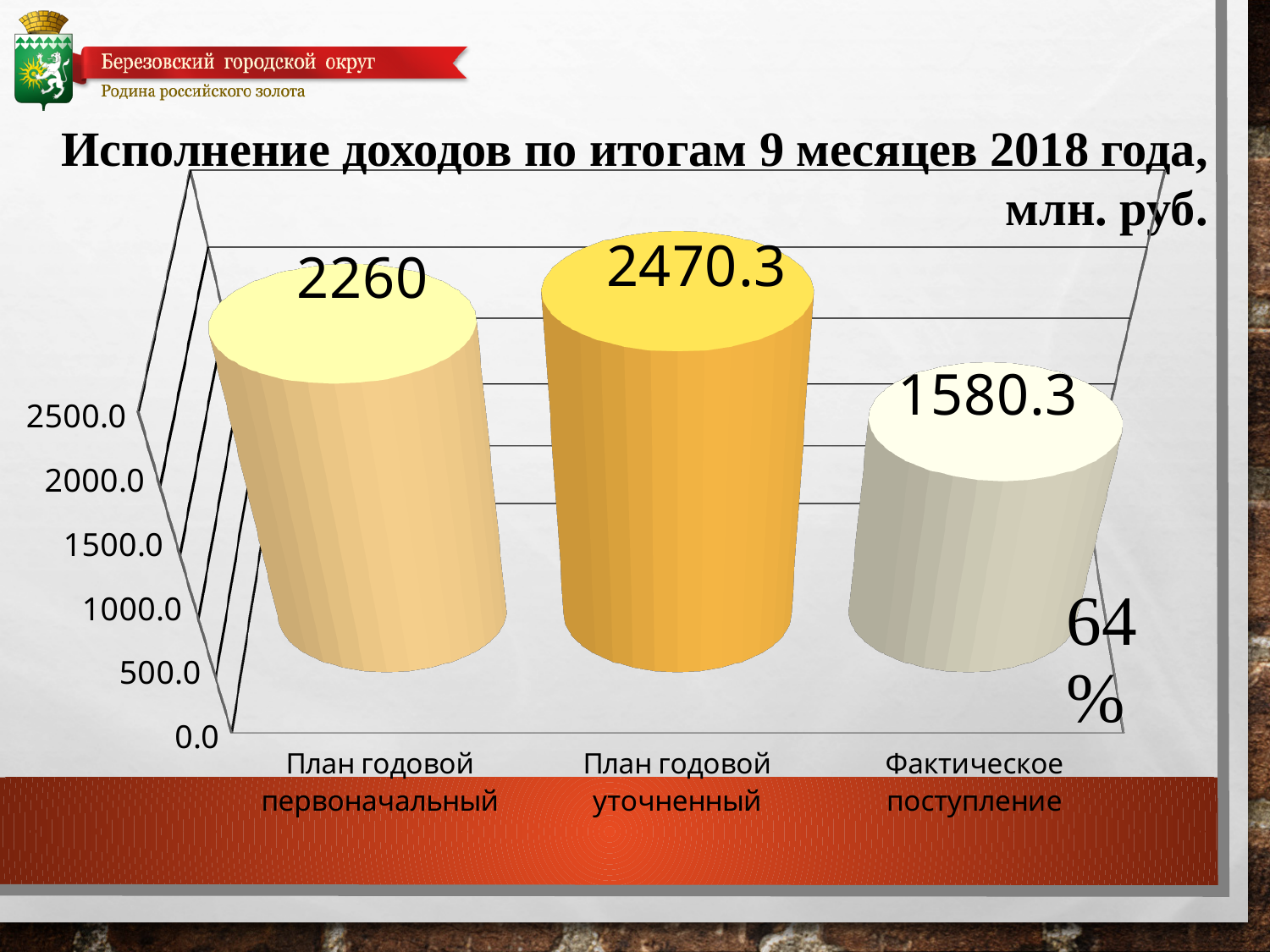
What is the value for "План годовой первоначальный"? 2260 What is the value for "Фактическое поступление"? 1580.3 What is the value for "План годовой уточненный"? 2470.3 What is the difference between "План годовой уточненный" and "План годовой первоначальный"? 210.3 What percentage is printed next to the "Фактическое поступление" bar? 64 % What kind of chart is shown on the slide? bar chart How many categories are shown in the chart? 3 Which is larger, "План годовой первоначальный" or "Фактическое поступление"? План годовой первоначальный Which category has the lowest value? Фактическое поступление Which category has the highest value? План годовой уточненный What is the difference between "План годовой уточненный" and "Фактическое поступление"? 890 Is the value for "Фактическое поступление" greater or less than 2000.0? less